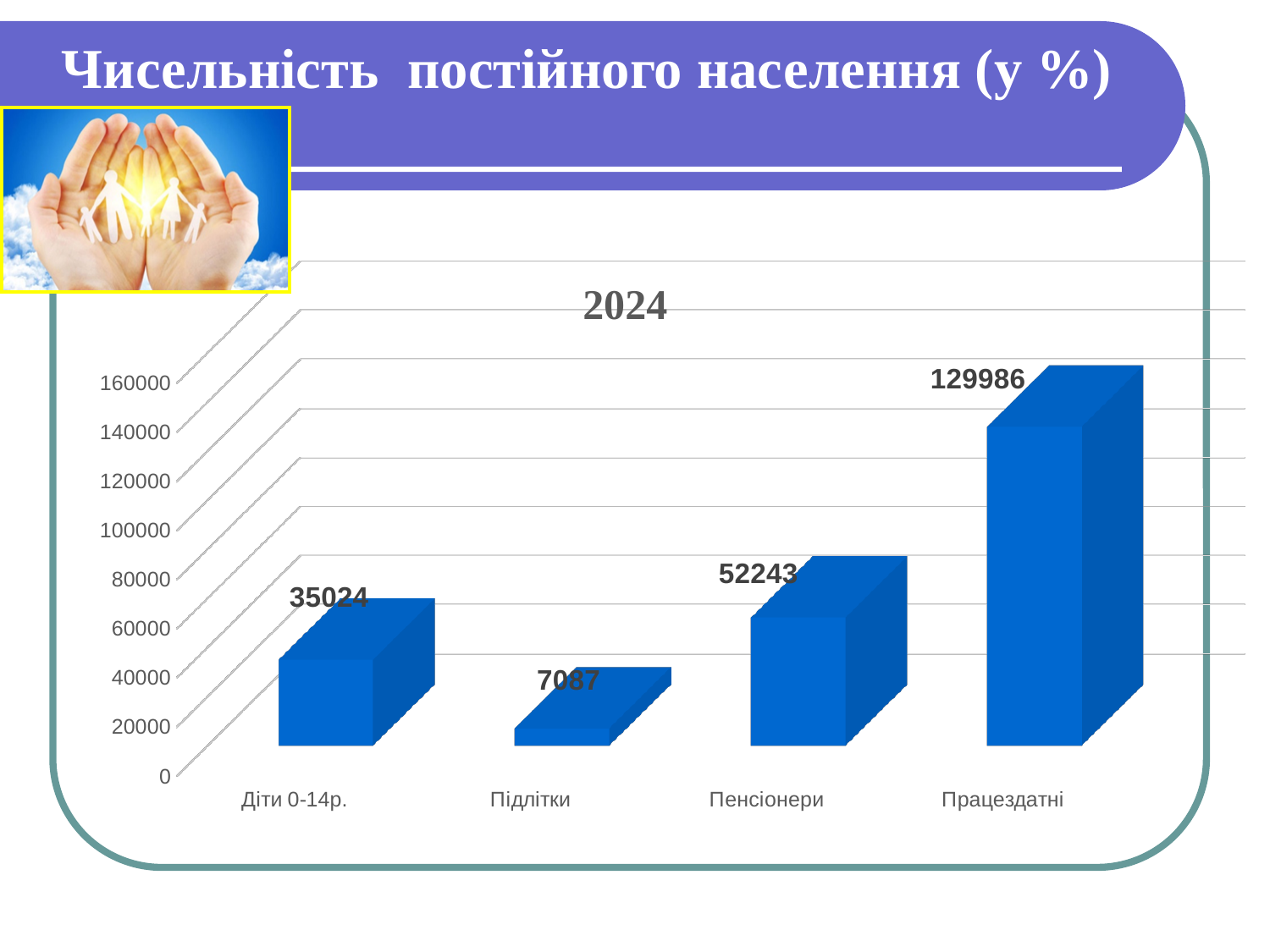
Which category has the highest value? Працездатні What is the value for Діти 0-14р.? 35024 What is the value for Підлітки? 7087 What is the difference between the values for Діти 0-14р. and Підлітки? 27937 What is the value for Працездатні? 129986 Which is larger, the value for Пенсіонери or the value for Діти 0-14р.? Пенсіонери What is the difference between the values for Працездатні and Пенсіонери? 77743 Which category has the lowest value? Підлітки What is the title of the chart? 2024 What is the value for Пенсіонери? 52243 What kind of chart is shown on the slide? bar chart How many categories are shown on the chart? 4